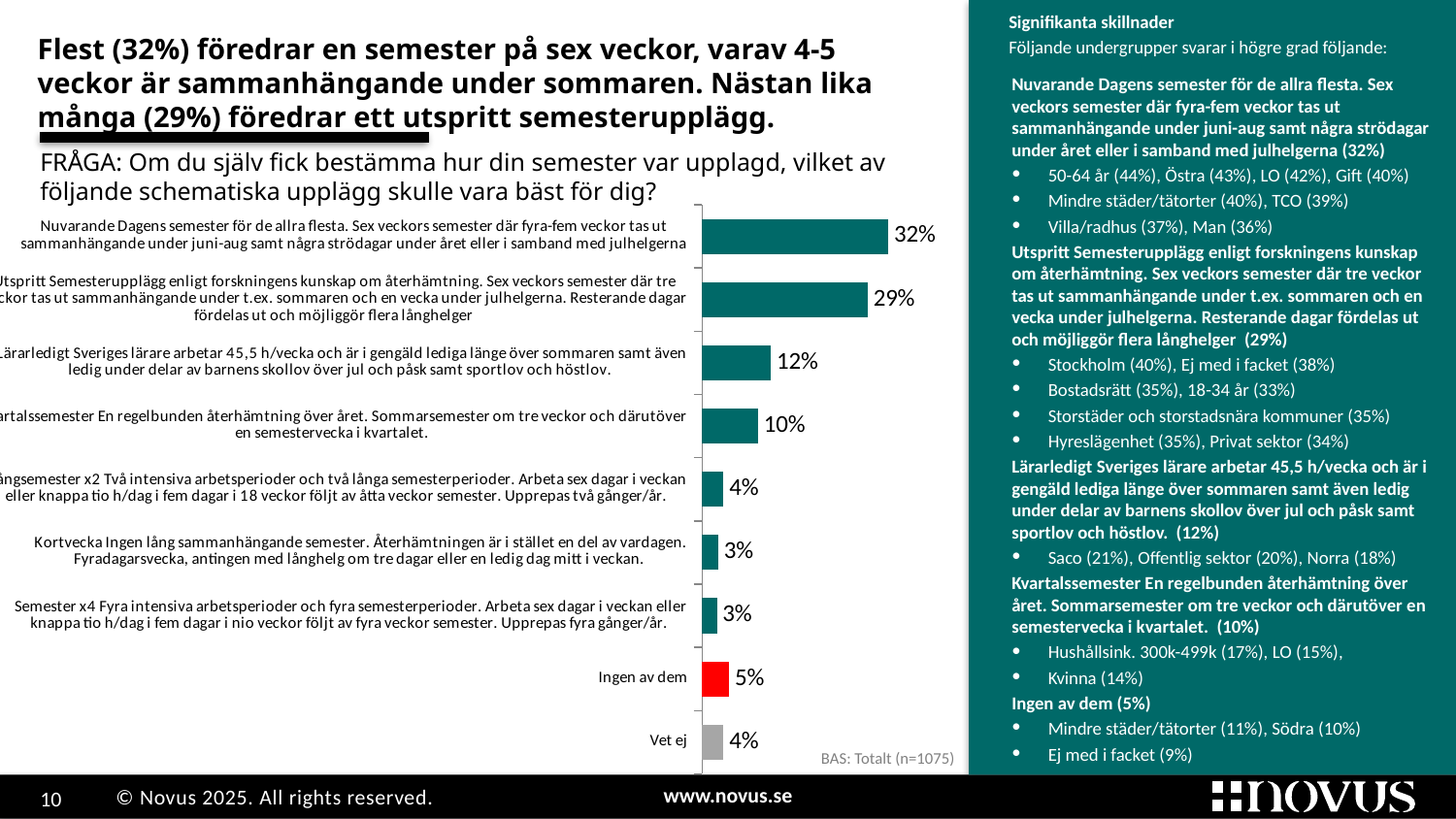
What percentage is shown for "Nuvarande Dagens semester för de allra flesta"? 32% What percentage is shown for "Vet ej"? 4% What is the difference in percentage points between "Nuvarande Dagens semester" (32%) and "Utspritt Semesterupplägg" (29%)? 3 percentage points Which is larger: the value for "Lärarledigt" or the value for "Kvartalssemester"? Lärarledigt What is the base (BAS) stated below the chart? Totalt (n=1075) What percentage is shown for "Lärarledigt Sveriges lärare arbetar 45,5 h/vecka"? 12% What percentage is shown for "Ingen av dem"? 5% What type of chart is shown on the slide? Bar chart Which category has the highest percentage? Nuvarande Dagens semester för de allra flesta What percentage is shown for "Utspritt Semesterupplägg enligt forskningens kunskap om återhämtning"? 29% How many categories (bars) are shown in the chart? 9 What is the difference in percentage points between "Ingen av dem" (5%) and "Vet ej" (4%)? 1 percentage point